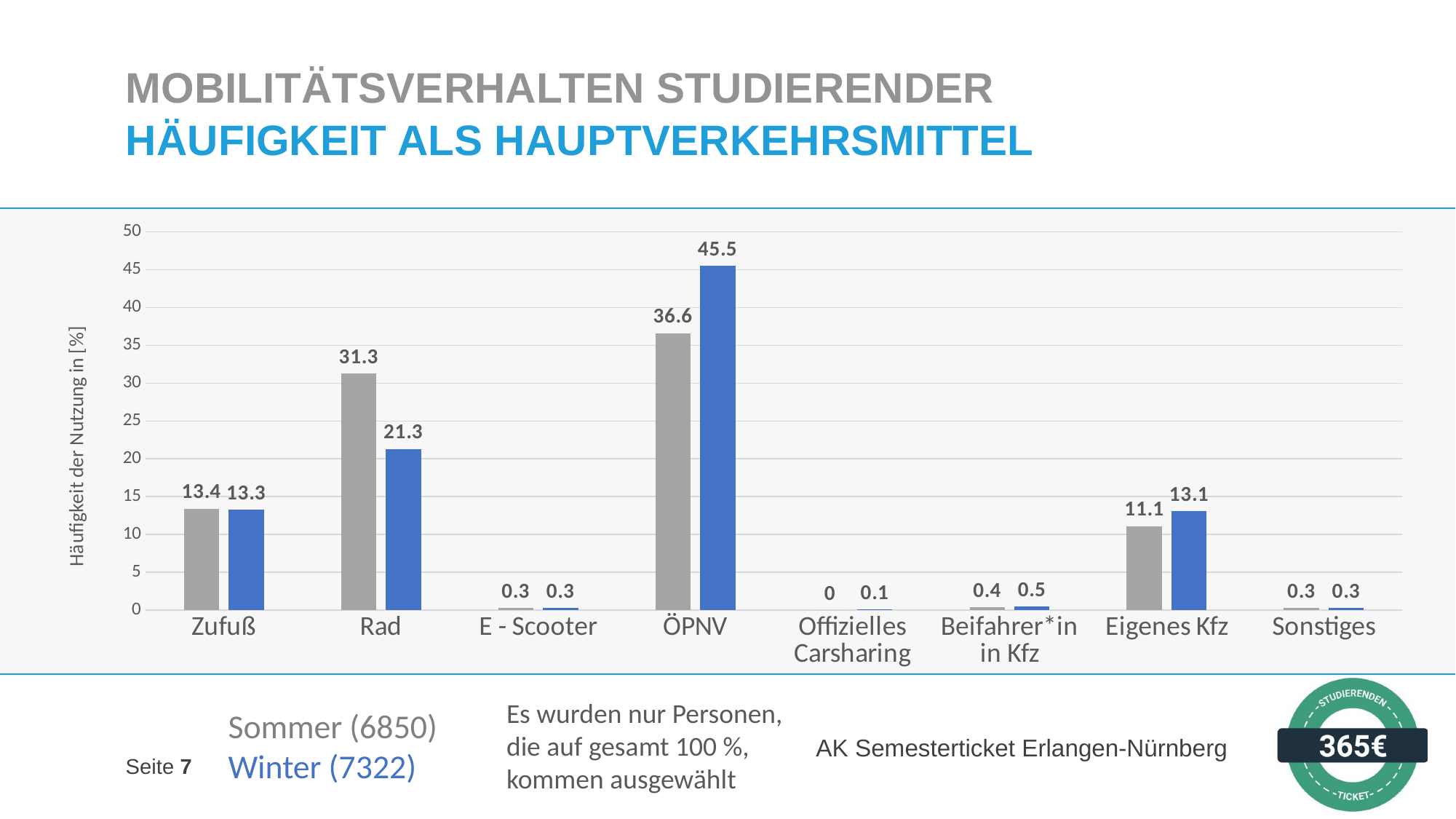
What is the difference between the Winter and Sommer values for ÖPNV? 8.9 Which is larger for Eigenes Kfz, the Sommer value or the Winter value? Winter What is the Sommer value for Offizielles Carsharing? 0 What is the Winter value for ÖPNV? 45.5 What is the Sommer value for Rad? 31.3 Which category has the lowest Sommer value? Offizielles Carsharing How many categories are shown on the x axis? 8 What is the difference between the Sommer and Winter values for Rad? 10 Which category has the highest Sommer value? ÖPNV What is the Winter value for Eigenes Kfz? 13.1 What type of chart is shown on the slide? Bar chart Which colour represents the Winter series? Blue